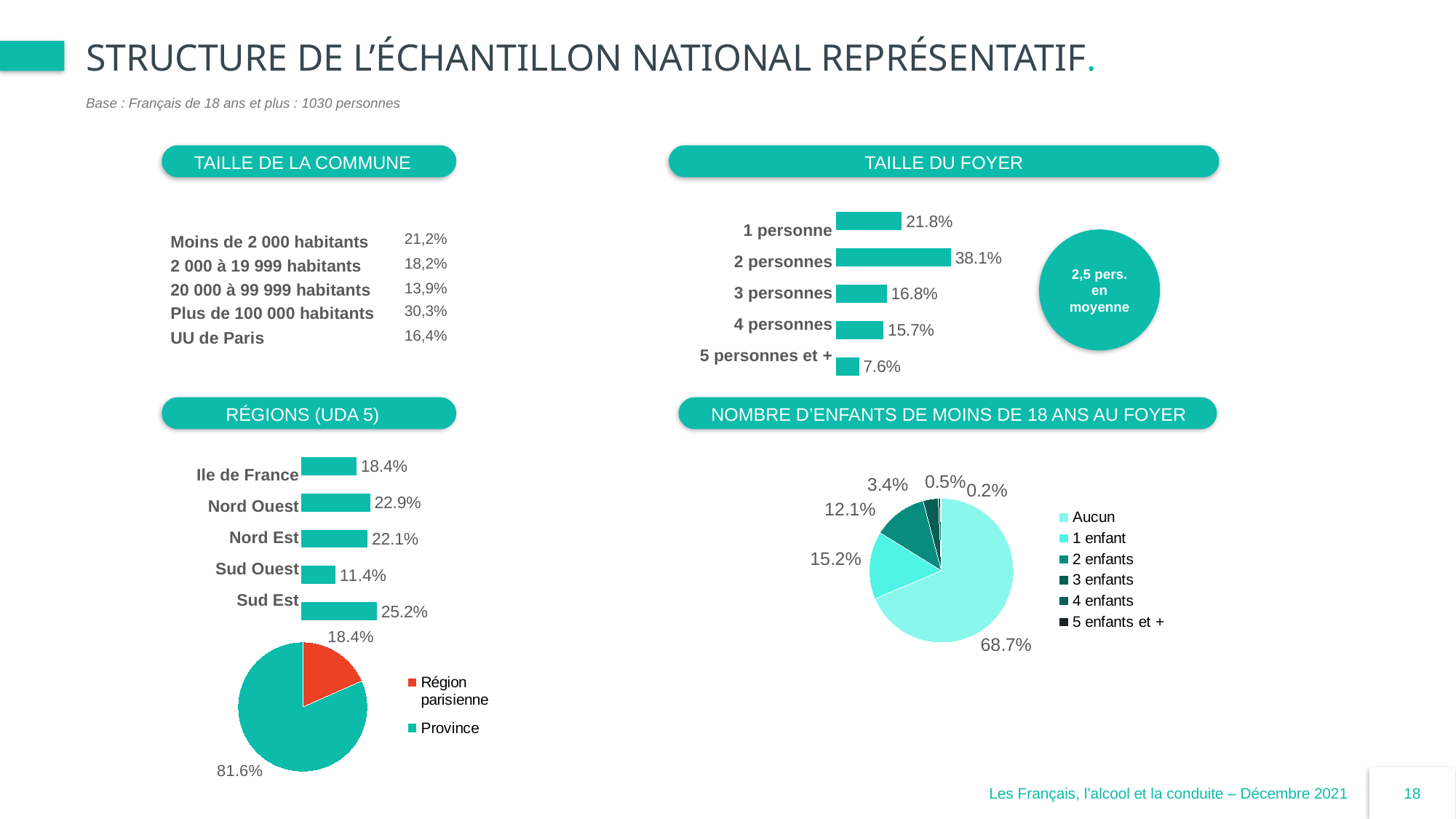
What kind of chart is used for the RÉGIONS (UDA 5) data? Bar chart How many categories does the TAILLE DU FOYER chart show? 5 In the RÉGIONS (UDA 5) bar chart, what is the value for Sud Ouest? 11.4% In the TAILLE DU FOYER chart, what is the value for 2 personnes? 38.1% In the TAILLE DU FOYER chart, which category has the lowest value? 5 personnes et + In the pie chart below the RÉGIONS (UDA 5) bars, what share does Province have? 81.6% In the RÉGIONS (UDA 5) bar chart, which is larger, Nord Ouest or Nord Est? Nord Ouest In the NOMBRE D'ENFANTS DE MOINS DE 18 ANS AU FOYER pie chart, what is the difference between the shares for 1 enfant and 2 enfants? 3.1% In the TAILLE DU FOYER chart, what is the difference between the values for 1 personne and 3 personnes? 5.0% In the RÉGIONS (UDA 5) bar chart, which region has the highest value? Sud Est How many entries does the legend of the NOMBRE D'ENFANTS DE MOINS DE 18 ANS AU FOYER pie chart list? 6 In the NOMBRE D'ENFANTS DE MOINS DE 18 ANS AU FOYER pie chart, what share does Aucun have? 68.7%